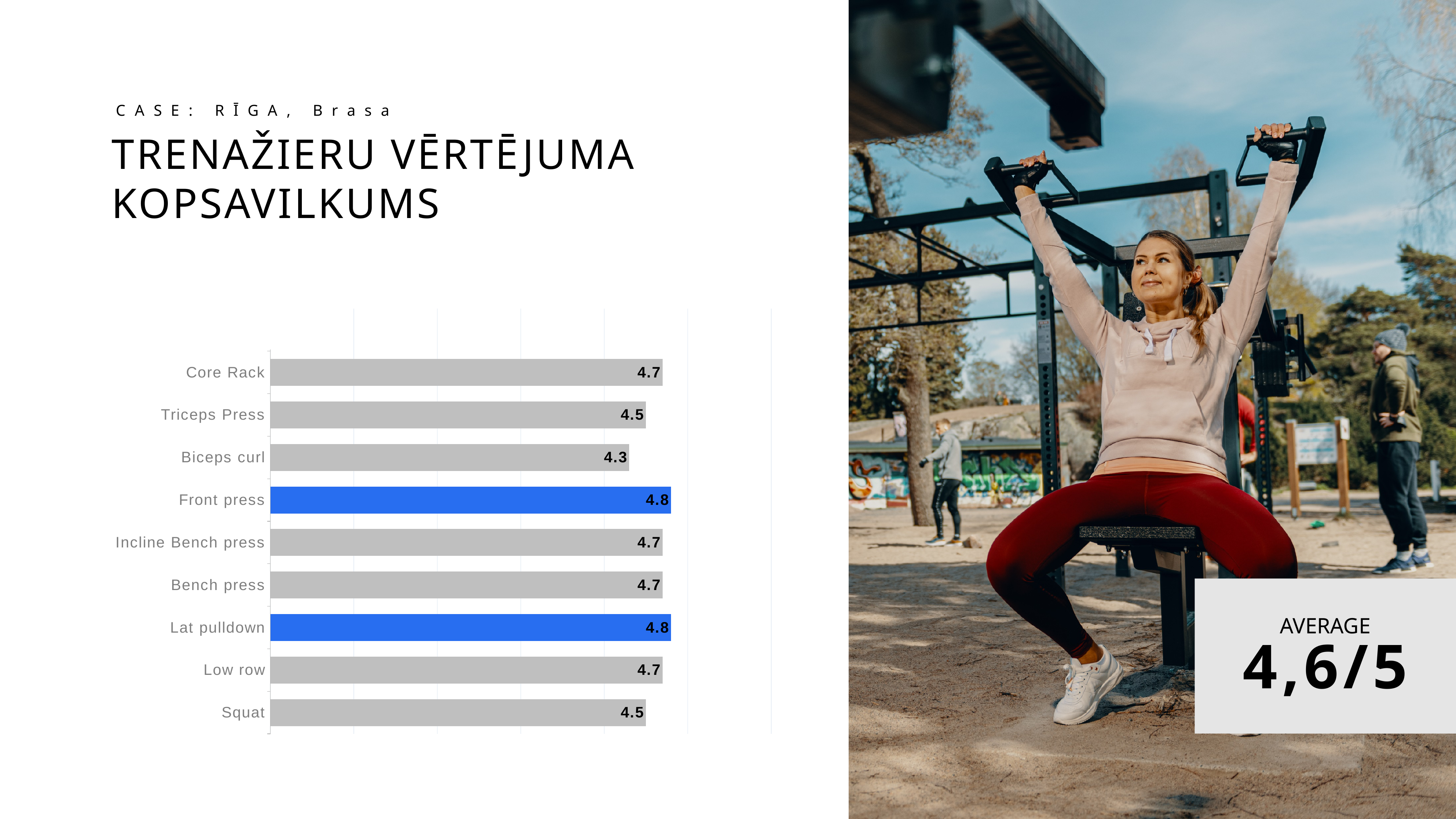
What is the difference between the ratings for Front press and Biceps curl? 0.5 What is the difference between the ratings for Core Rack and Triceps Press? 0.2 Which two categories share the highest rating? Front press and Lat pulldown What is the rating for Squat? 4.5 Which has a higher rating, Triceps Press or Incline Bench press? Incline Bench press How many categories are shown in the chart? 9 What is the rating for Core Rack? 4.7 Which bars are highlighted in blue? Front press and Lat pulldown What is the rating for Lat pulldown? 4.8 Which category has the lowest rating? Biceps curl What kind of chart is shown on the slide? Bar chart What is the rating for Biceps curl? 4.3